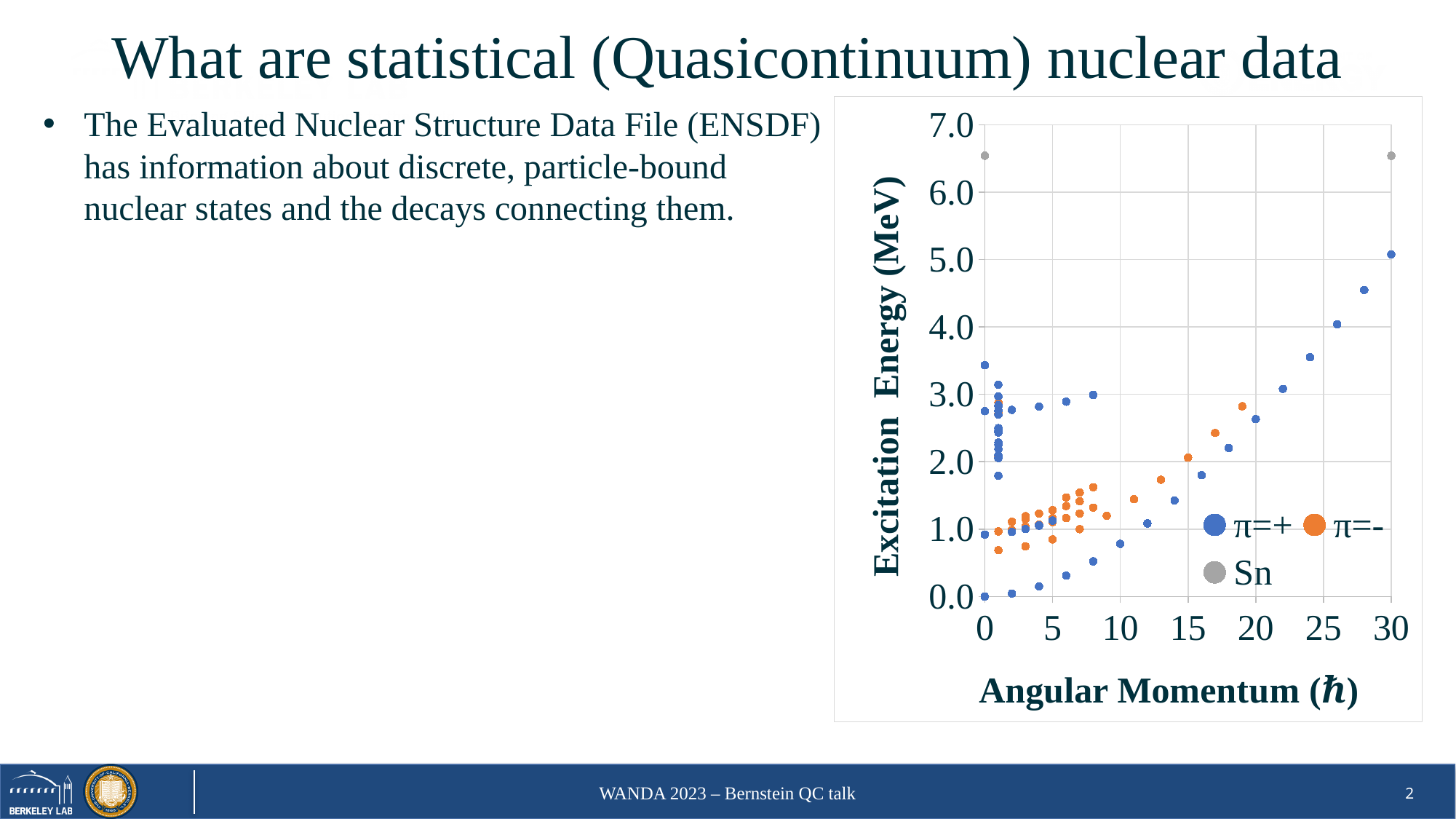
Which has the higher excitation energy: the Sn point at angular momentum 30 or the π=+ point at angular momentum 30? Sn For the π=+ series, does the excitation energy rise or fall as angular momentum increases from 15 to 30? rise What kind of chart is shown on the slide? scatter chart What are the three series named in the chart's legend? π=+, π=-, Sn How many series does the chart's legend list? 3 Is the excitation energy of the π=+ point at angular momentum 10 greater or less than 1.0 MeV? less Is the excitation energy of the Sn points greater or less than 6.0 MeV? greater How many Sn points are plotted on the chart? 2 What is the title of the chart's x axis? Angular Momentum (ℏ) Which series contains the point with the highest excitation energy on the chart? Sn Is the excitation energy of the π=+ point at angular momentum 30 greater or less than 4.0 MeV? greater